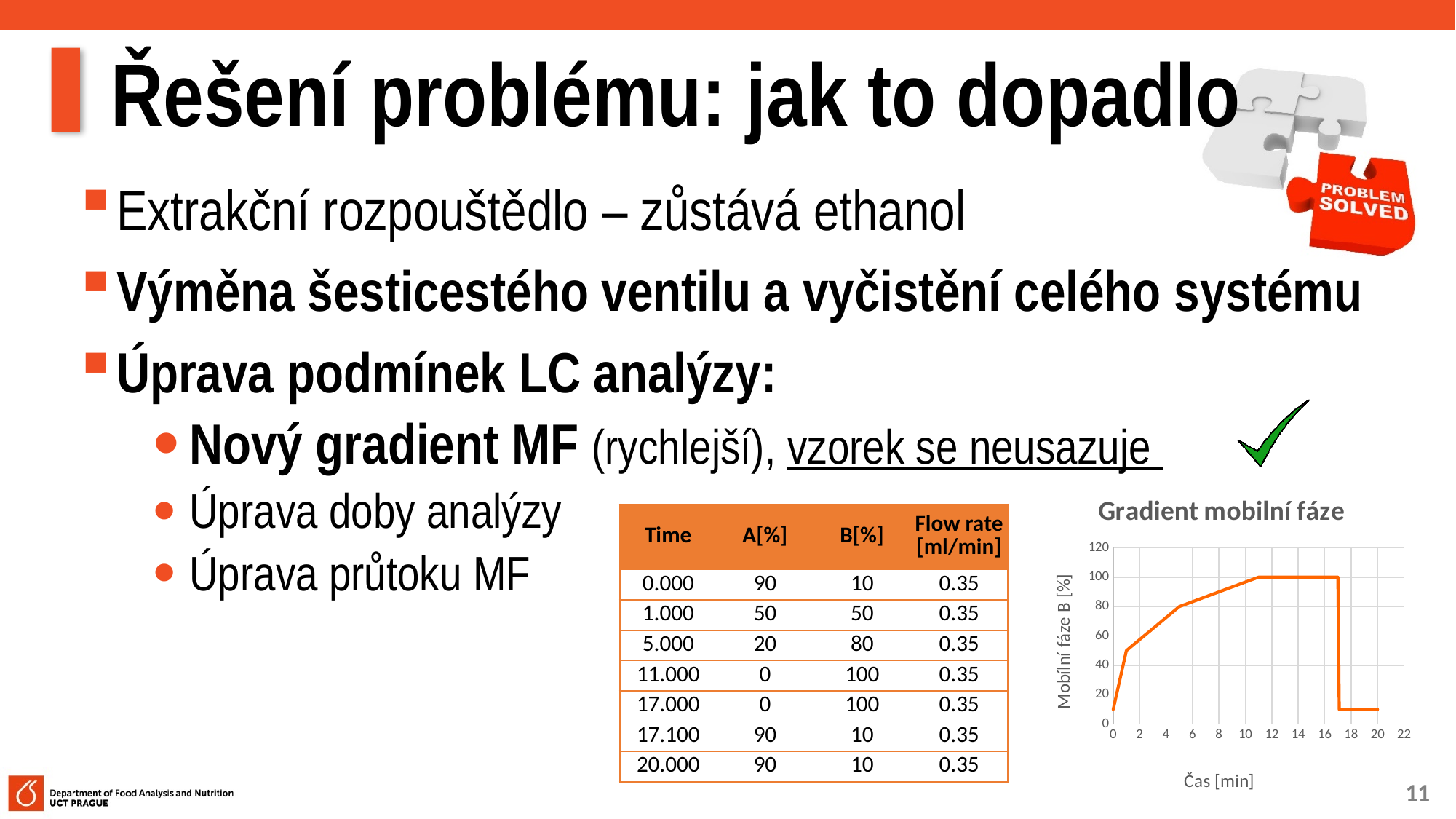
What is the label of the x axis of the 'Gradient mobilní fáze' chart? Čas [min] In the 'Gradient mobilní fáze' chart, is the value at 20 min greater or less than 20? less In the 'Gradient mobilní fáze' chart, is the value at 1 min greater or less than 40? greater In the 'Gradient mobilní fáze' chart, which is larger: the value at 5 min or the value at 20 min? 5 min In the 'Gradient mobilní fáze' chart, is the value at 0 min greater or less than 20? less In the 'Gradient mobilní fáze' chart, does the value rise or fall between 0 min and 11 min? rise In the 'Gradient mobilní fáze' chart, what is the value of Mobilní fáze B [%] at 5 min? 80 What is the title of the chart on the slide? Gradient mobilní fáze In the 'Gradient mobilní fáze' chart, what is the value of Mobilní fáze B [%] at 11 min? 100 What kind of chart is 'Gradient mobilní fáze'? line chart What is the highest value of Mobilní fáze B [%] reached in the 'Gradient mobilní fáze' chart? 100 In the 'Gradient mobilní fáze' chart, does the value rise or fall between 17 min and 20 min? fall